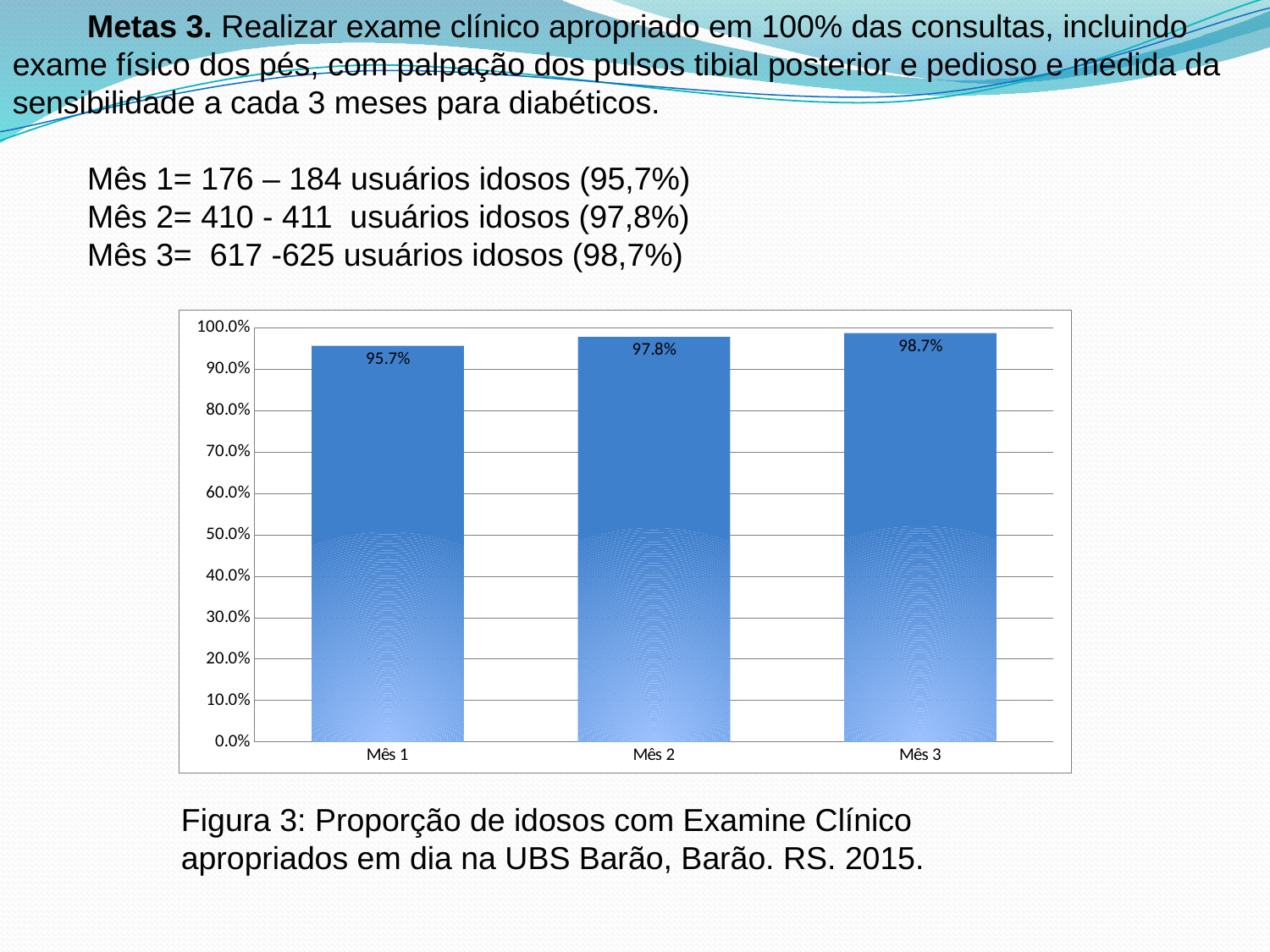
What is the value for Mês 2? 97.8% What is the value for Mês 1? 95.7% What is the value for Mês 3? 98.7% Do the values rise or fall from Mês 1 to Mês 3? rise What is the difference between the values for Mês 2 and Mês 1? 2.1% How many months are shown on the x axis? 3 What kind of chart is shown on the slide? bar chart Which month has the lowest value? Mês 1 What is the difference between the values for Mês 3 and Mês 1? 3.0% Is the value for Mês 1 greater or less than 90.0%? greater Which month has the highest value? Mês 3 Which is larger, the value for Mês 1 or the value for Mês 2? Mês 2